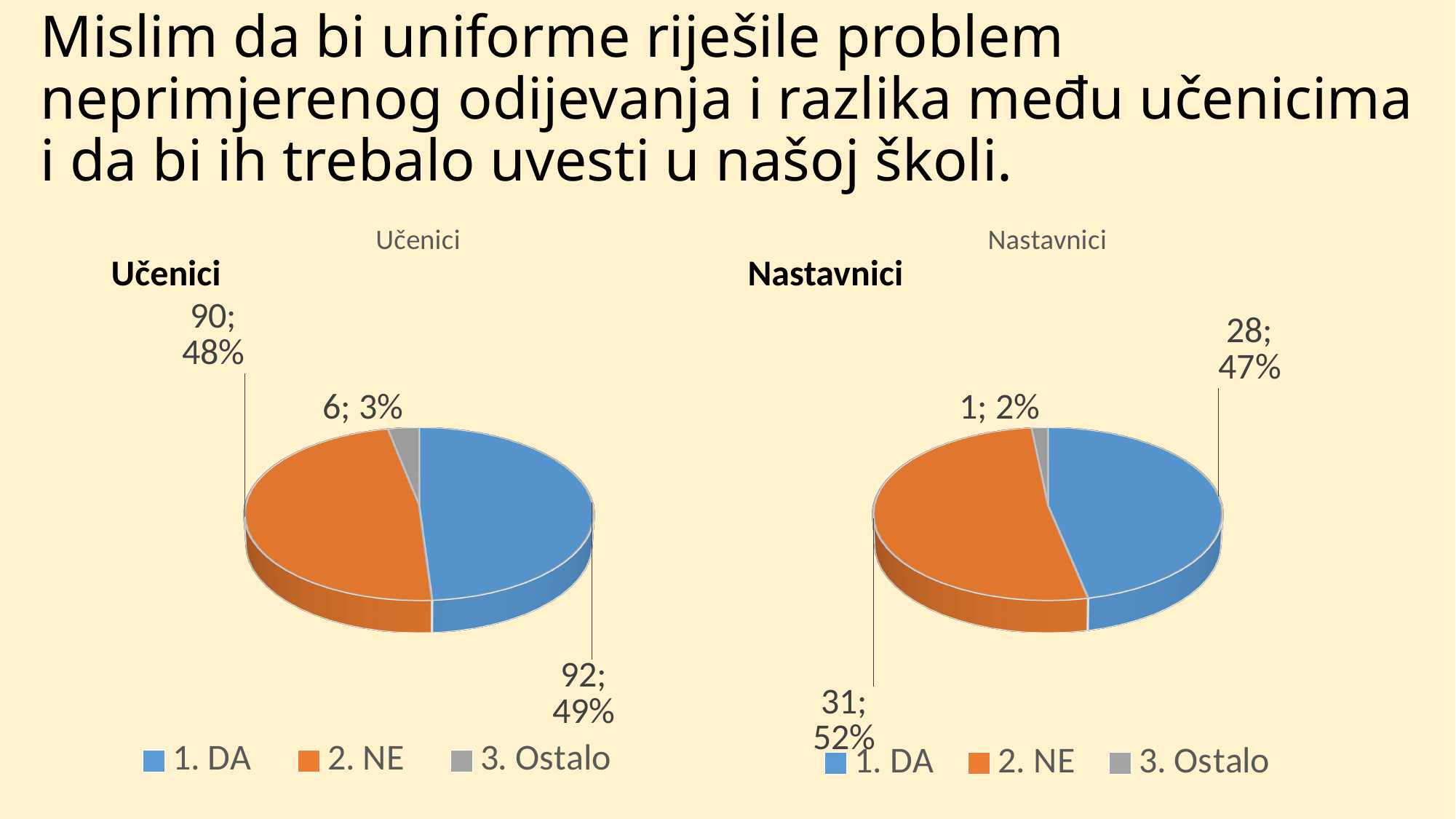
In the Učenici chart, what colour is the 3. Ostalo slice? Grey In the Učenici chart, what percentage share does 2. NE have? 48% How many categories does the legend of the Nastavnici chart list? 3 In the Učenici chart, how many respondents answered 1. DA? 92 In the Nastavnici chart, how many respondents answered 2. NE? 31 What type of chart is the Učenici chart? Pie chart In the Nastavnici chart, which is larger, the count for 1. DA or 2. NE? 2. NE In the Učenici chart, which category has the largest slice? 1. DA In the Nastavnici chart, what percentage share does 1. DA have? 47% In the Nastavnici chart, which category has the smallest slice? 3. Ostalo In the Učenici chart, what is the difference between the counts for 1. DA and 2. NE? 2 In the Nastavnici chart, which category has the largest slice? 2. NE